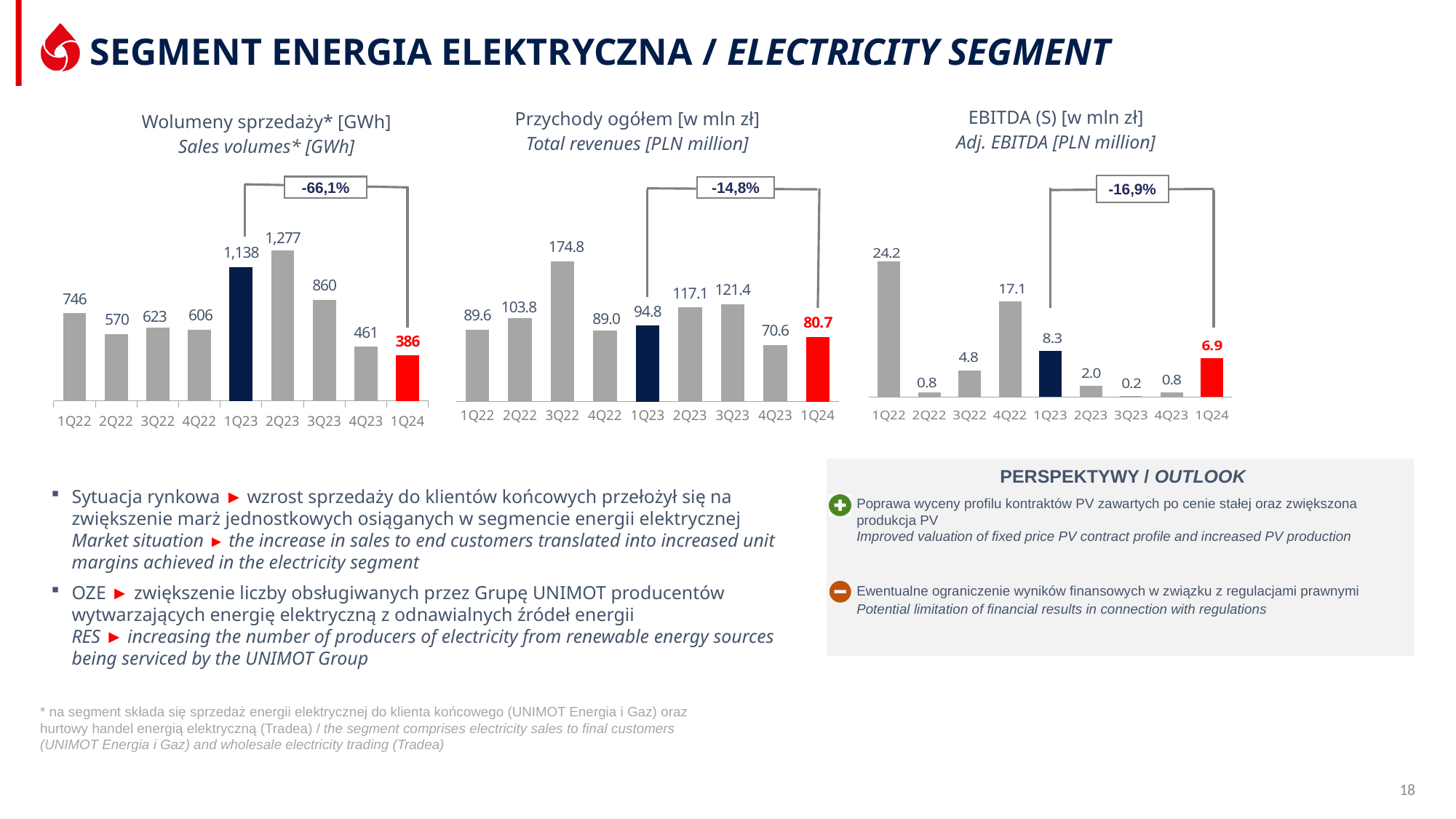
In the Sales volumes [GWh] chart, what is the difference between 1Q23 and 1Q24? 752 In the Sales volumes [GWh] chart, what is the value for 1Q24? 386 In the Adj. EBITDA [PLN million] chart, which quarter has the highest value? 1Q22 In the Total revenues [PLN million] chart, which is larger, 2Q23 or 3Q23? 3Q23 In the Total revenues [PLN million] chart, which quarter has the lowest value? 4Q23 How many quarters are shown in the Total revenues [PLN million] chart? 9 In the Sales volumes [GWh] chart, which quarter has the highest value? 2Q23 In the Total revenues [PLN million] chart, what is the value for 3Q22? 174.8 In the Adj. EBITDA [PLN million] chart, what is the value for 1Q23? 8.3 In the Adj. EBITDA [PLN million] chart, what is the difference between 1Q23 and 1Q24? 1.4 What type of chart is the Sales volumes [GWh] chart? Bar chart What percentage change is shown between 1Q23 and 1Q24 in the Total revenues [PLN million] chart? -14,8%